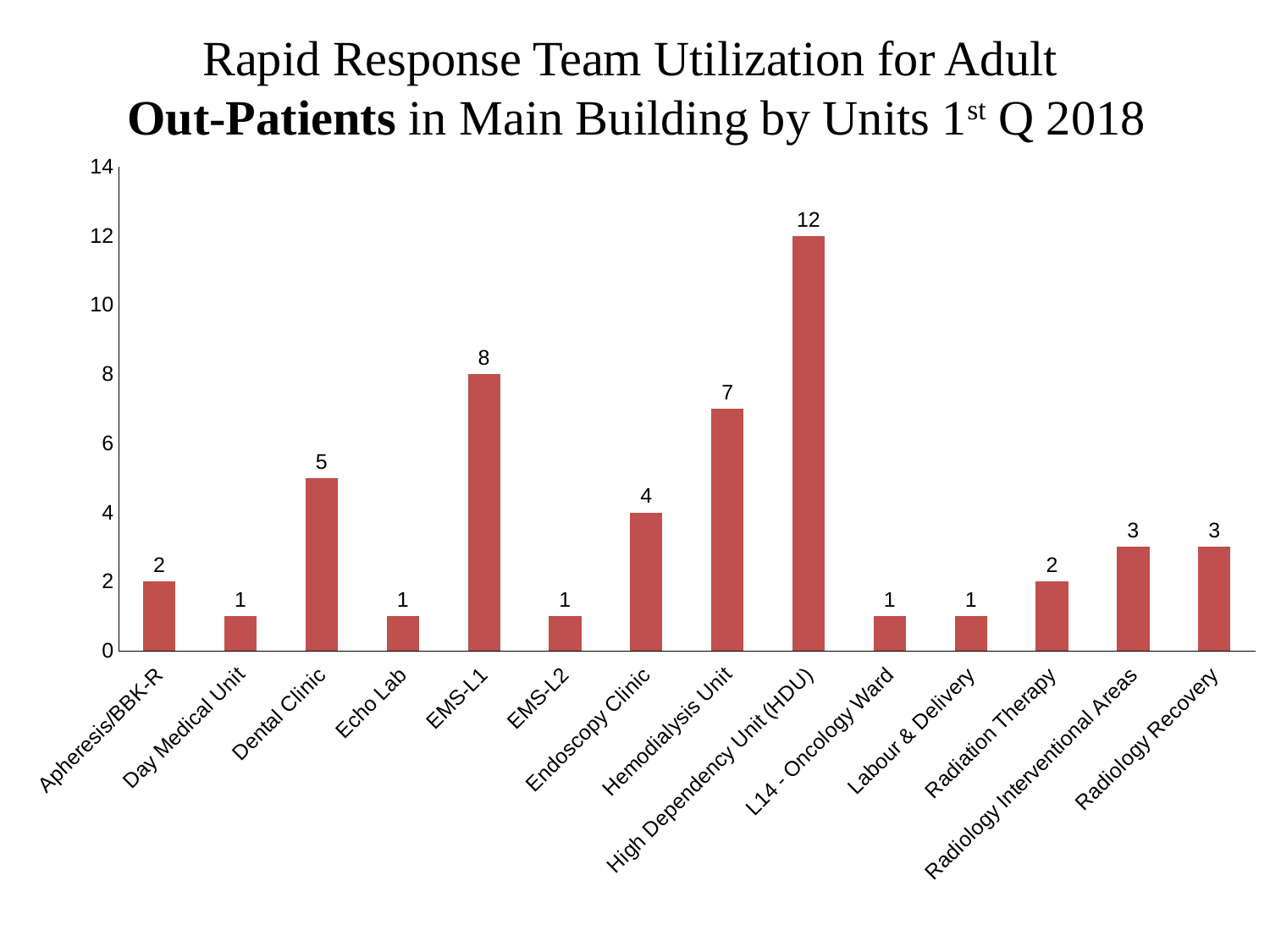
What kind of chart is this? bar chart What is the value for Radiology Recovery? 3 What is the difference between the values for EMS-L1 and EMS-L2? 7 How many units have a value of 1? 5 What is the value for High Dependency Unit (HDU)? 12 Which is larger, the value for EMS-L1 or the value for Endoscopy Clinic? EMS-L1 What is the value for EMS-L1? 8 Is the value for Hemodialysis Unit greater or less than 6? greater How many units are shown on the x axis? 14 What is the value for Dental Clinic? 5 What is the difference between the values for High Dependency Unit (HDU) and Hemodialysis Unit? 5 Which unit has the highest value? High Dependency Unit (HDU)